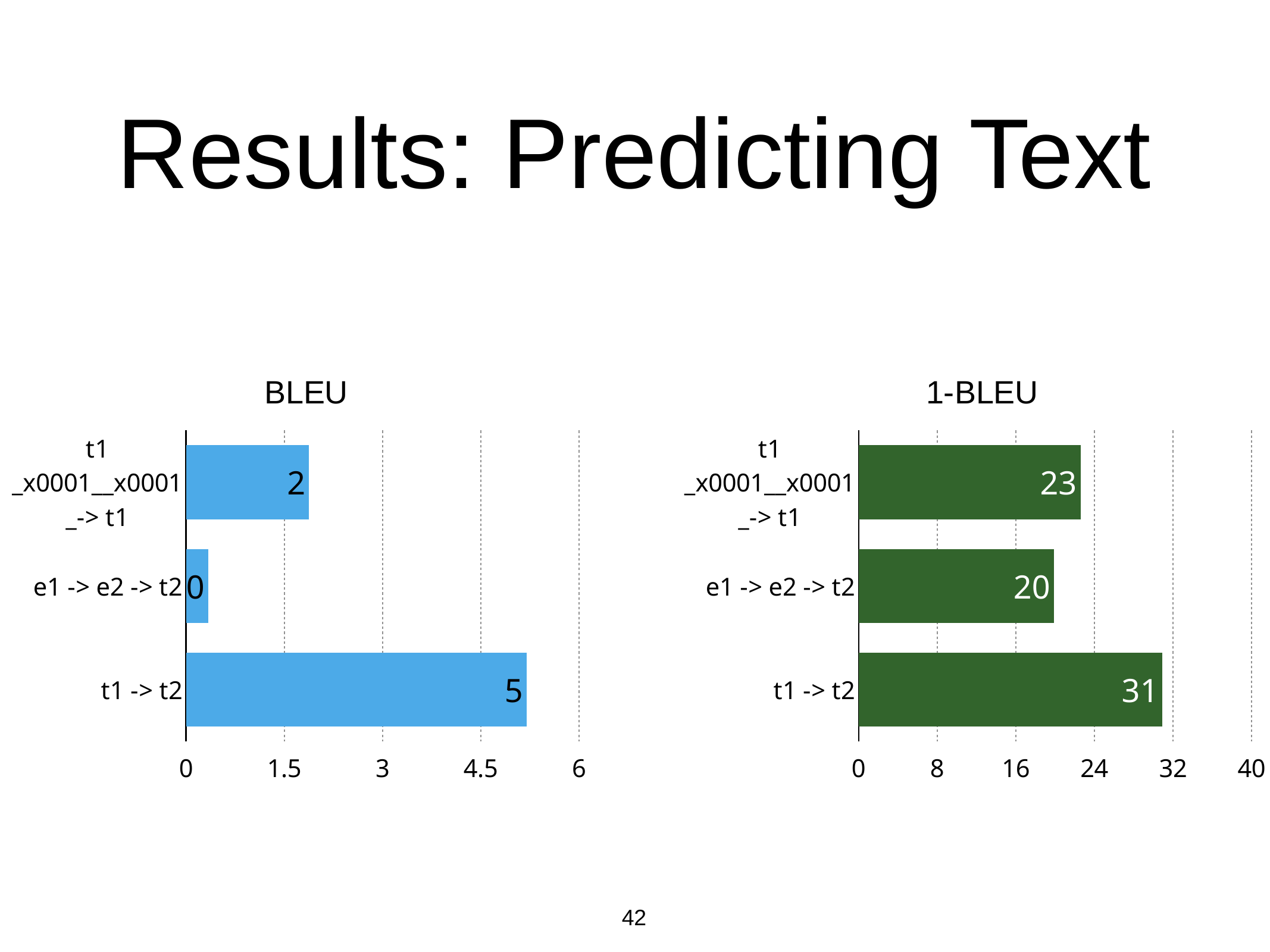
What kind of chart is the 1-BLEU chart? bar chart In the BLEU chart, what is the value for e1 -> e2 -> t2? 0 In the 1-BLEU chart, what is the difference between the values for t1 -> t2 and e1 -> e2 -> t2? 11 In the BLEU chart, what is the value for t1 -> t2? 5 In the 1-BLEU chart, what is the value labelled on the topmost bar? 23 In the 1-BLEU chart, what is the value for e1 -> e2 -> t2? 20 How many categories does the BLEU chart show? 3 In the 1-BLEU chart, which category has the lowest value? e1 -> e2 -> t2 In the 1-BLEU chart, what is the value for t1 -> t2? 31 In the BLEU chart, which category has the highest value? t1 -> t2 In the 1-BLEU chart, is the value for t1 -> t2 greater or less than 24? greater In the BLEU chart, which is larger: the value for t1 -> t2 or the value for e1 -> e2 -> t2? t1 -> t2